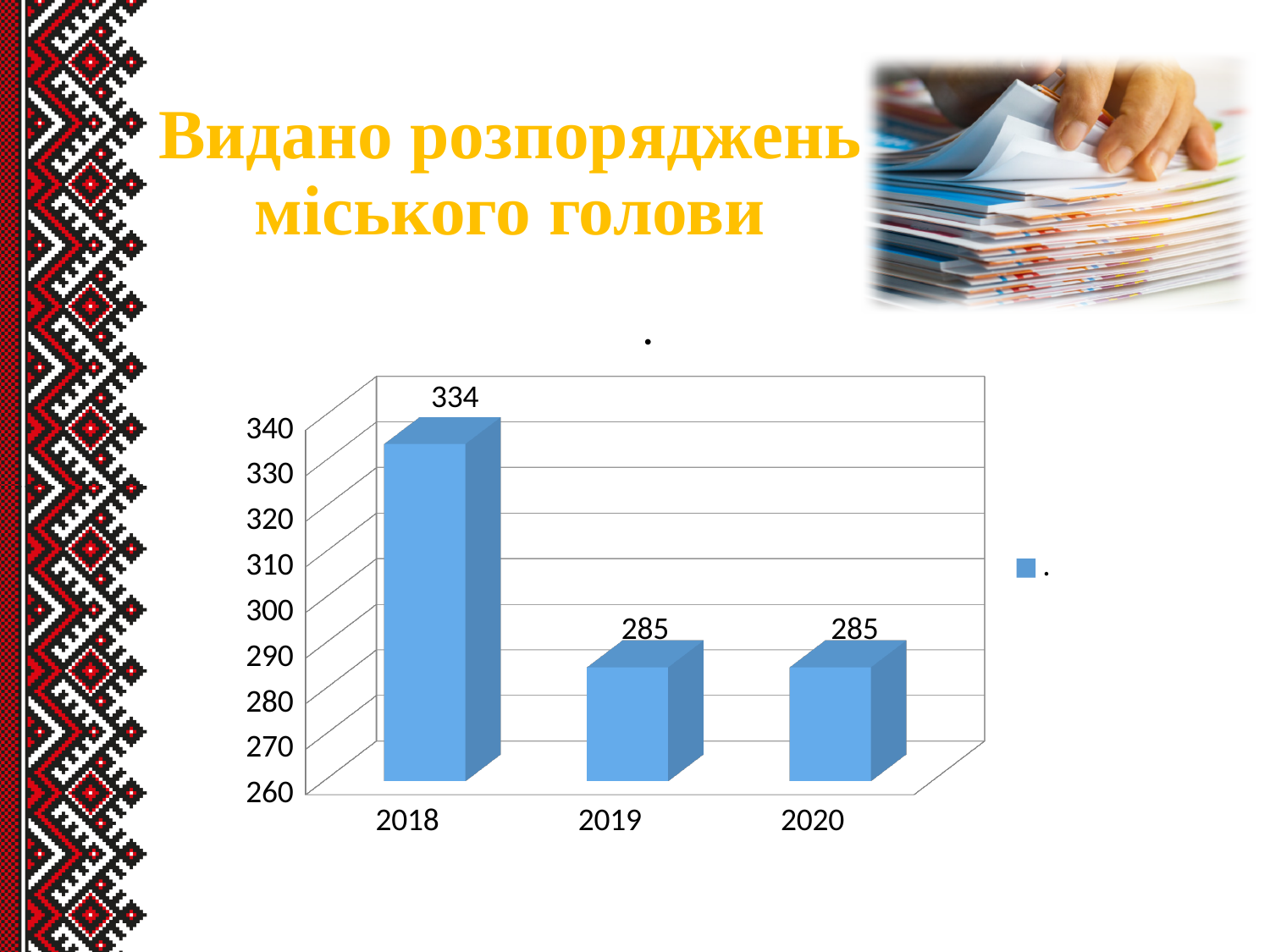
What is the lowest value shown on the vertical axis? 260 What is the value for 2019? 285 What kind of chart is shown on the slide? bar chart Which year has the highest value? 2018 Which is larger, the value for 2018 or the value for 2020? 2018 Is the value for 2018 greater or less than 320? greater How many years are shown on the x axis? 3 What is the value for 2020? 285 Is the value for 2019 greater or less than 300? less What is the difference between the values for 2018 and 2019? 49 What is the value for 2018? 334 Do the values rise or fall from 2018 to 2019? fall